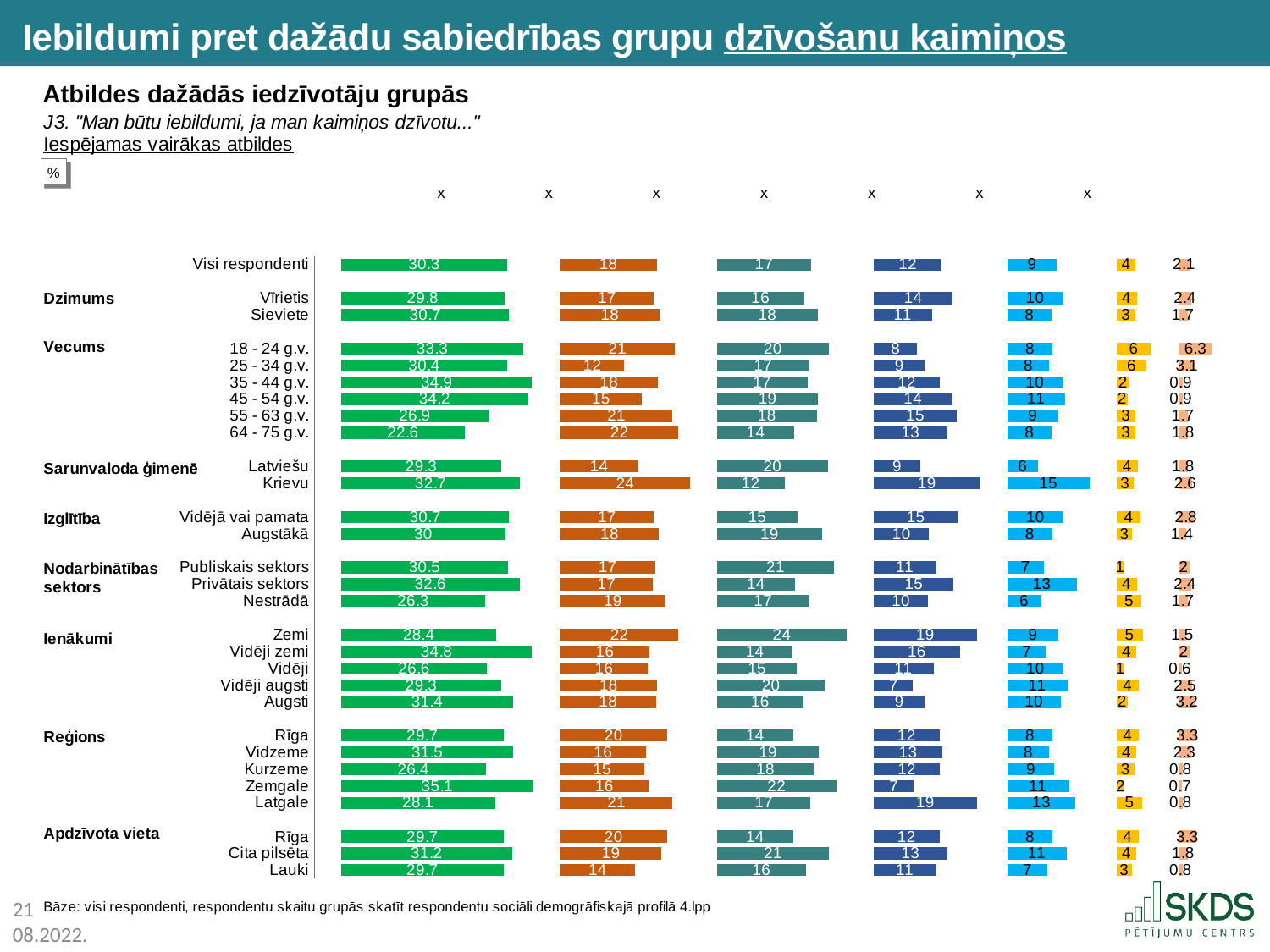
Among the Vecums (age) groups, which has the highest value in the first (green) bar column? 35 - 44 g.v. What is the difference between Sieviete and Vīrietis in the first (green) bar column? 0.9 Among the Reģions groups, which has the lowest value in the first (green) bar column? Kurzeme What is the value for Krievu in the second (orange) bar column? 24 Among the Ienākumi groups, which has the highest value in the first (green) bar column? Vidēji zemi What kind of chart is shown on the slide? bar chart What is the value for 18 - 24 g.v. in the last (rightmost) column? 6.3 In the first (green) bar column, which is larger: Latviešu or Krievu? Krievu What is the difference between Krievu and Latviešu in the second (orange) bar column? 10 How many age groups are listed under Vecums? 6 What is the value for Visi respondenti in the first (green) bar column? 30.3 How many bar columns (series) are shown for each respondent group? 7